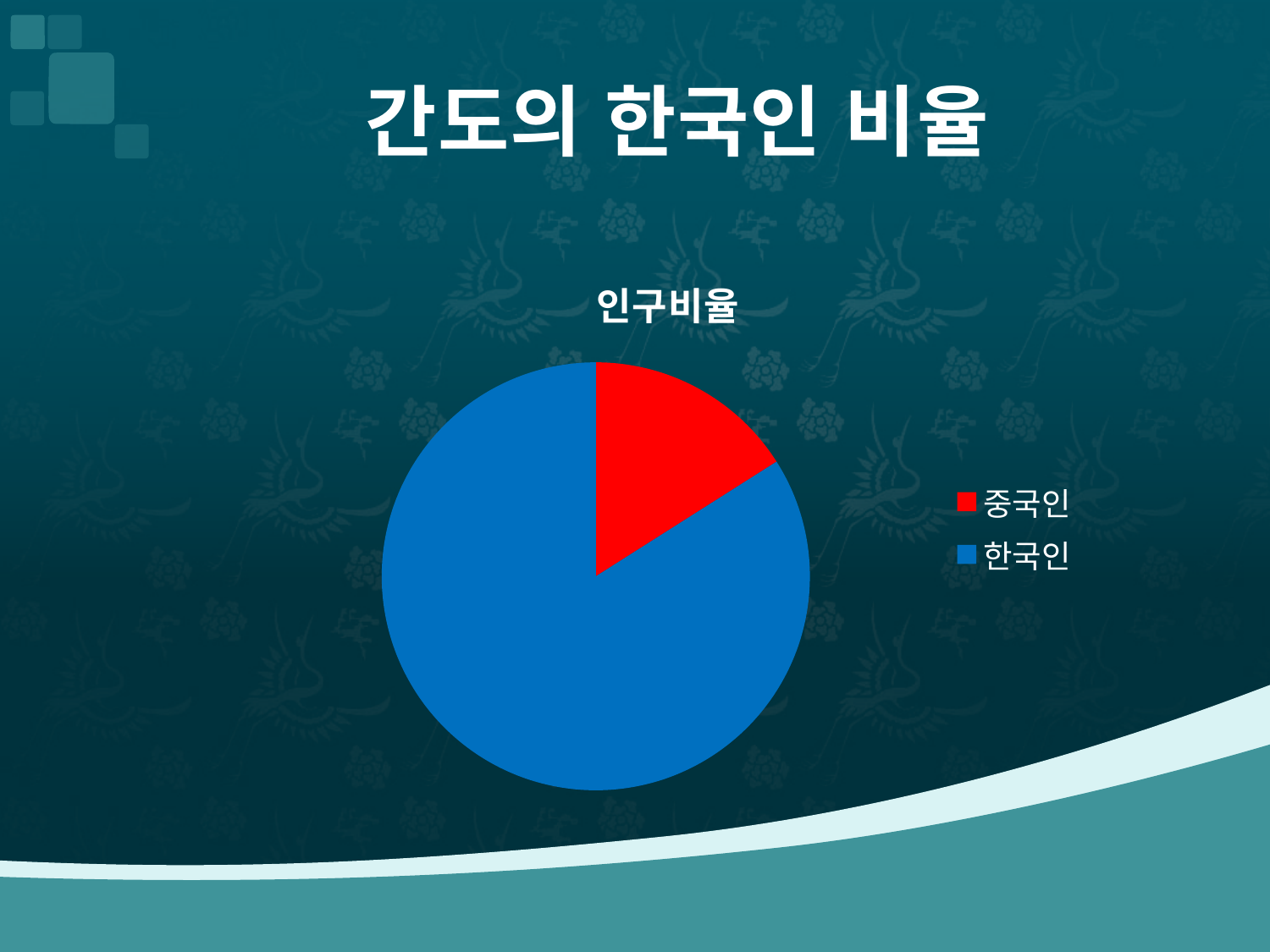
What kind of chart is shown on the slide? pie chart What colour is the slice for 중국인? red What is the title of the chart? 인구비율 How many slices does the pie chart have? 2 Which is larger, the slice for 중국인 or the slice for 한국인? 한국인 Which category has the smallest slice of the pie? 중국인 How many entries does the legend list? 2 Which category has the largest slice of the pie? 한국인